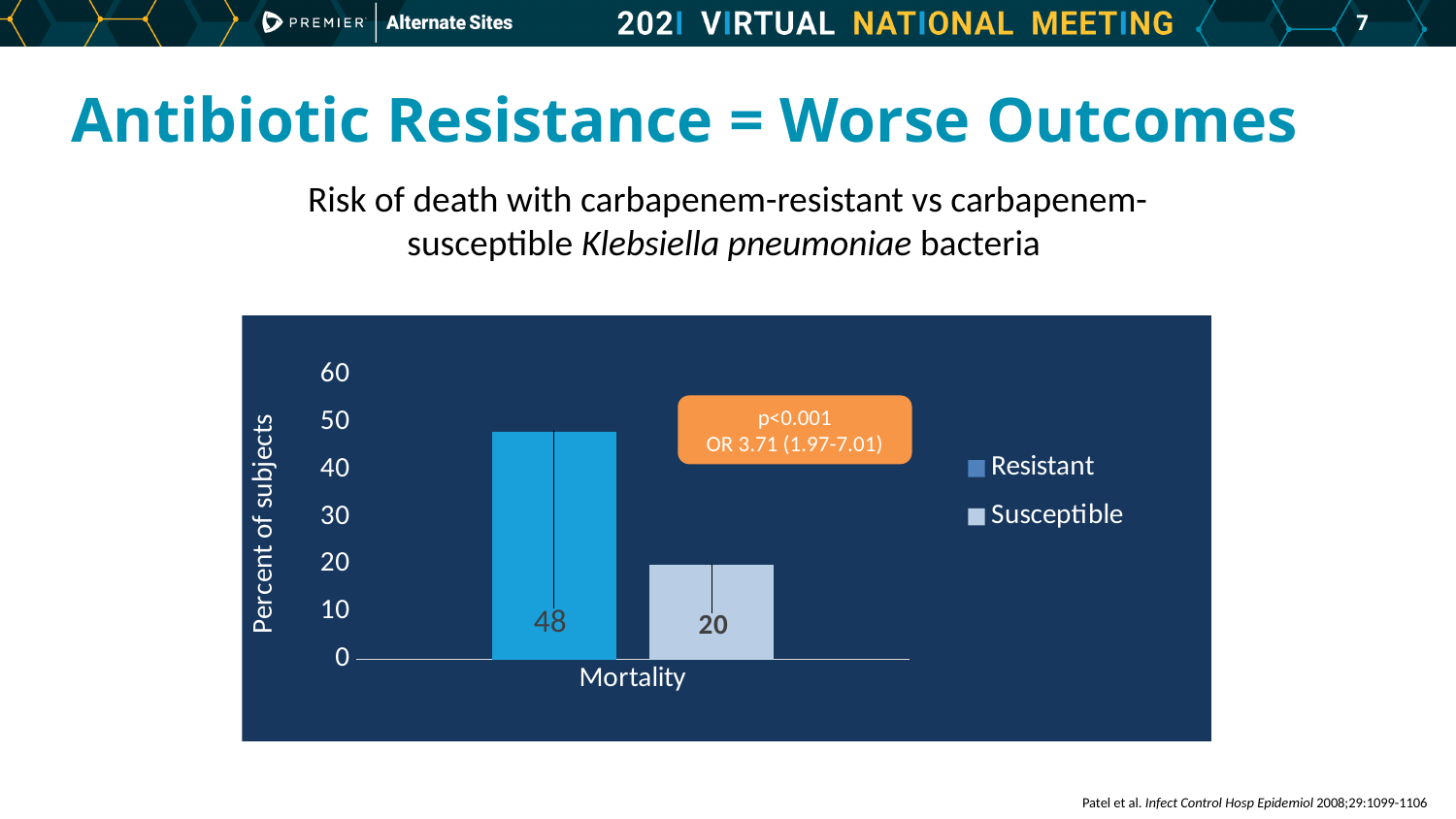
What is the value for Resistant in the Mortality category? 48 Is the value for Susceptible greater or less than 30? less How many categories are shown on the x axis? 1 What is the category label on the x axis? Mortality What is the value for Susceptible in the Mortality category? 20 What is the difference between the Resistant and Susceptible mortality values? 28 What is the highest value shown on the y axis? 60 What kind of chart is shown on the slide? Bar chart Is the value for Resistant greater or less than 40? greater Which series has the higher mortality value, Resistant or Susceptible? Resistant How many series does the legend list? 2 What is the label on the y axis of the chart? Percent of subjects